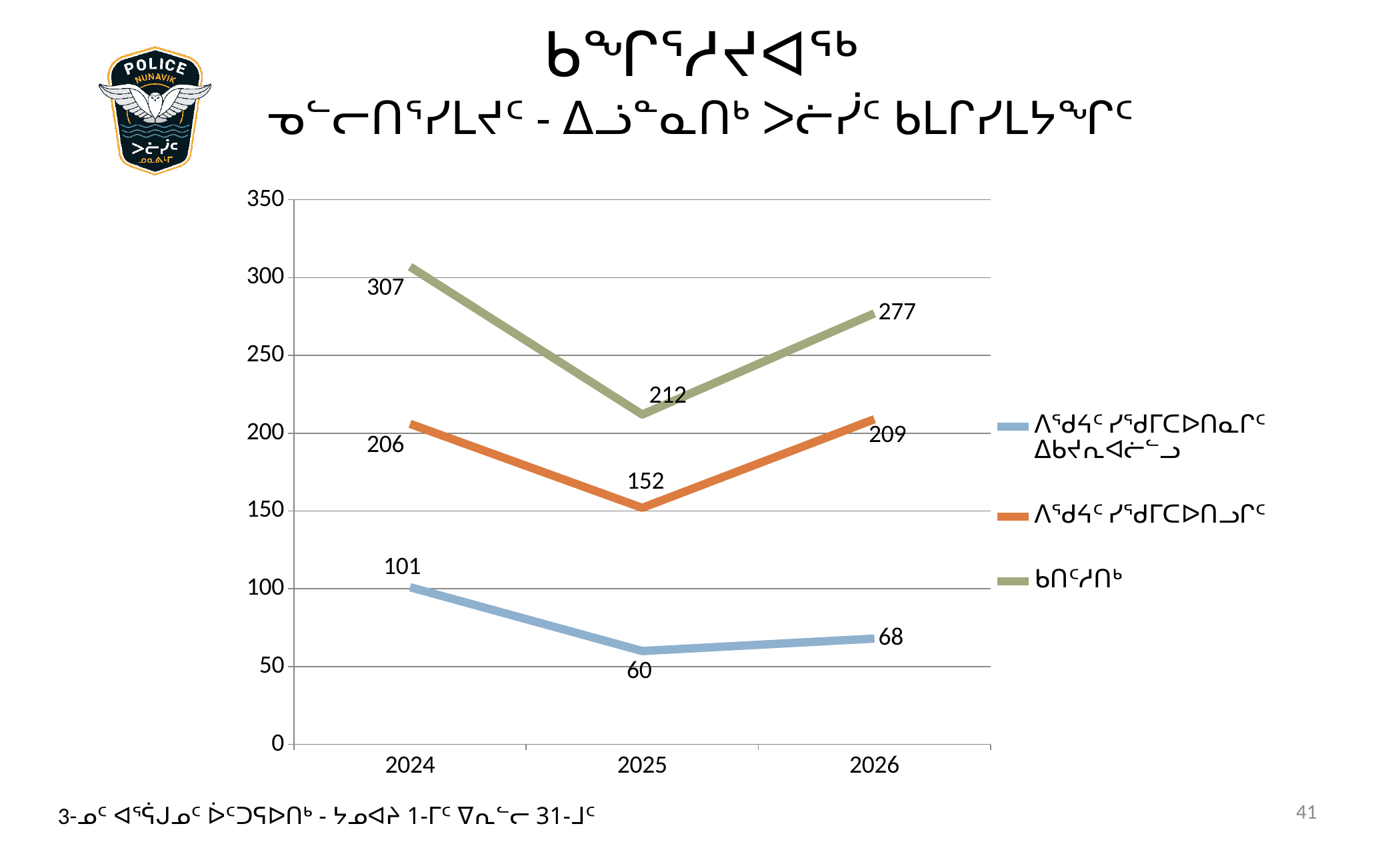
How many series does the legend list? 3 Does the blue line rise or fall from 2024 to 2025? fall What is the value of the orange line in 2025? 152 How many years are shown on the x axis? 3 Is the green line's value in 2026 greater or less than 250? greater In which year is the blue line at its highest? 2024 What is the difference between the green line's values in 2024 and 2025? 95 In which year is the green line at its lowest? 2025 What kind of chart is shown on the slide? line chart Which is larger, the orange line's value in 2024 or in 2026? 2026 What is the value of the blue line in 2026? 68 What is the value of the green line in 2024? 307